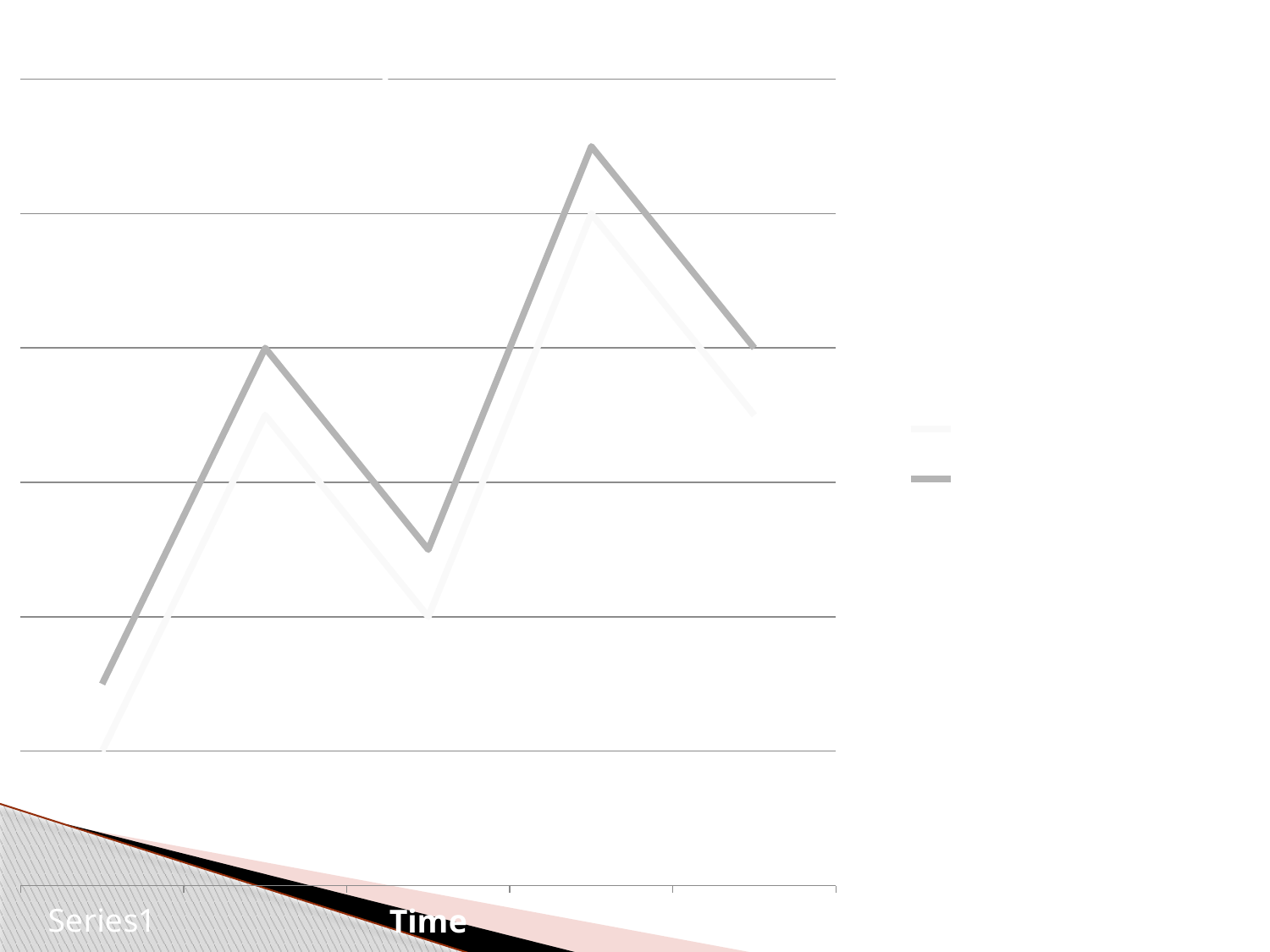
What kind of chart is shown on the slide? line chart Does the gray line rise or fall from the second point to the third point? fall Does the gray line rise or fall from the first point to the second point? rise On the gray line, is the second point higher or lower than the third point? higher Which point on the gray line is the lowest? the first point What is the title of the x axis? Time Which point on the gray line is the highest? the fourth point How many series does the legend list? 2 On the gray line, is the fifth point higher or lower than the first point? higher How many data points does the gray line have? 5 Does the gray line rise or fall from the fourth point to the fifth point? fall